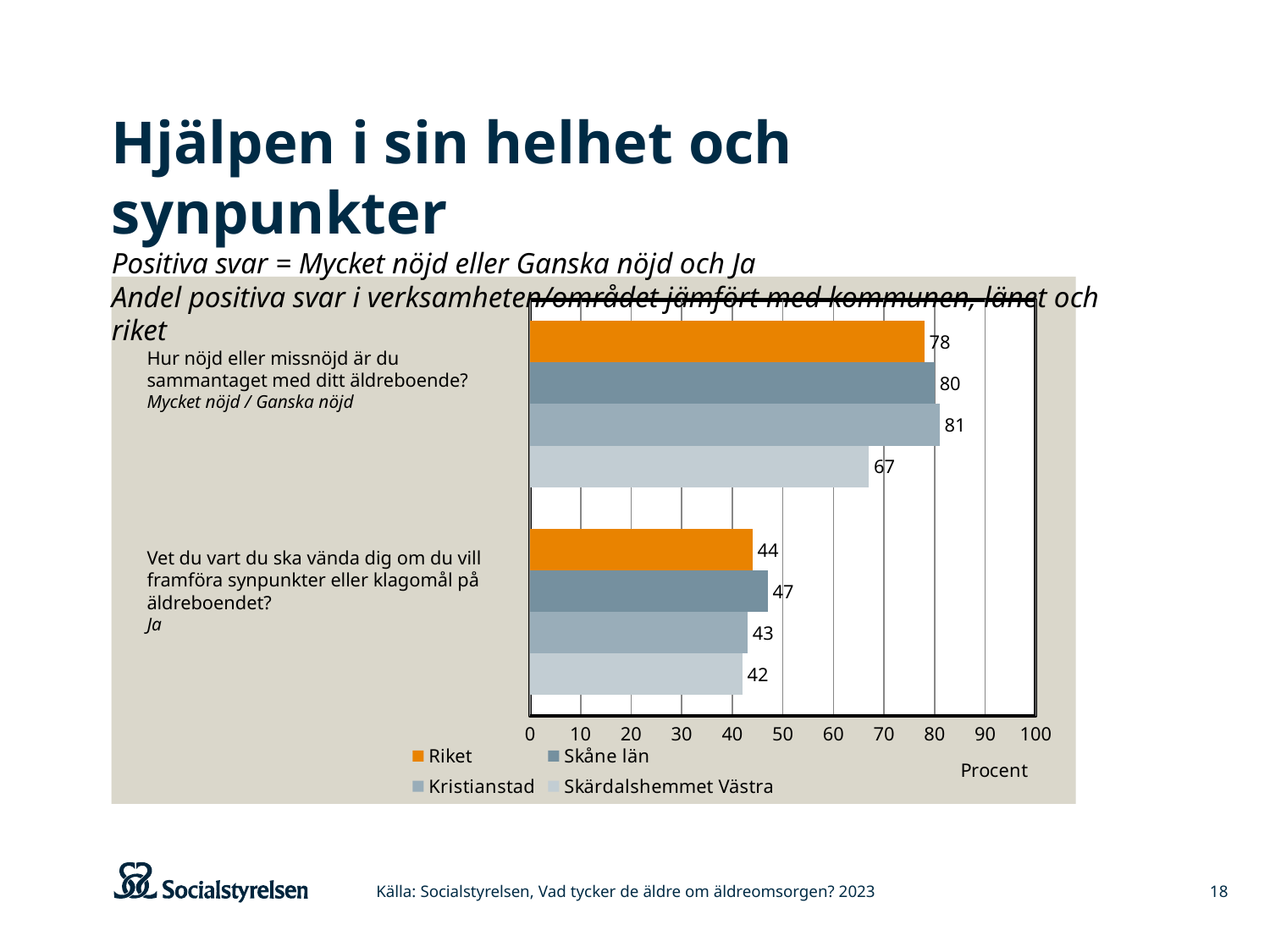
Is the value for Skärdalshemmet Västra on the question about knowing where to turn with synpunkter eller klagomål greater or less than 50? less What is the value for Riket on the question about overall satisfaction with the äldreboende (Mycket nöjd / Ganska nöjd)? 78 How many series does the legend list? 4 What is the value for Skåne län on the question about knowing where to turn with synpunkter eller klagomål? 47 What unit is shown on the x axis of the chart? Procent Which series has the highest value on the question about overall satisfaction with the äldreboende? Kristianstad What is the value for Kristianstad on the question about knowing where to turn with synpunkter eller klagomål? 43 What is the difference between Kristianstad and Skärdalshemmet Västra on the question about overall satisfaction with the äldreboende? 14 What kind of chart is shown on the slide? bar chart What is the value for Skärdalshemmet Västra on the question about overall satisfaction with the äldreboende? 67 Which series has the lowest value on the question about overall satisfaction with the äldreboende? Skärdalshemmet Västra Which is larger on the question about knowing where to turn with synpunkter eller klagomål: Riket or Skåne län? Skåne län